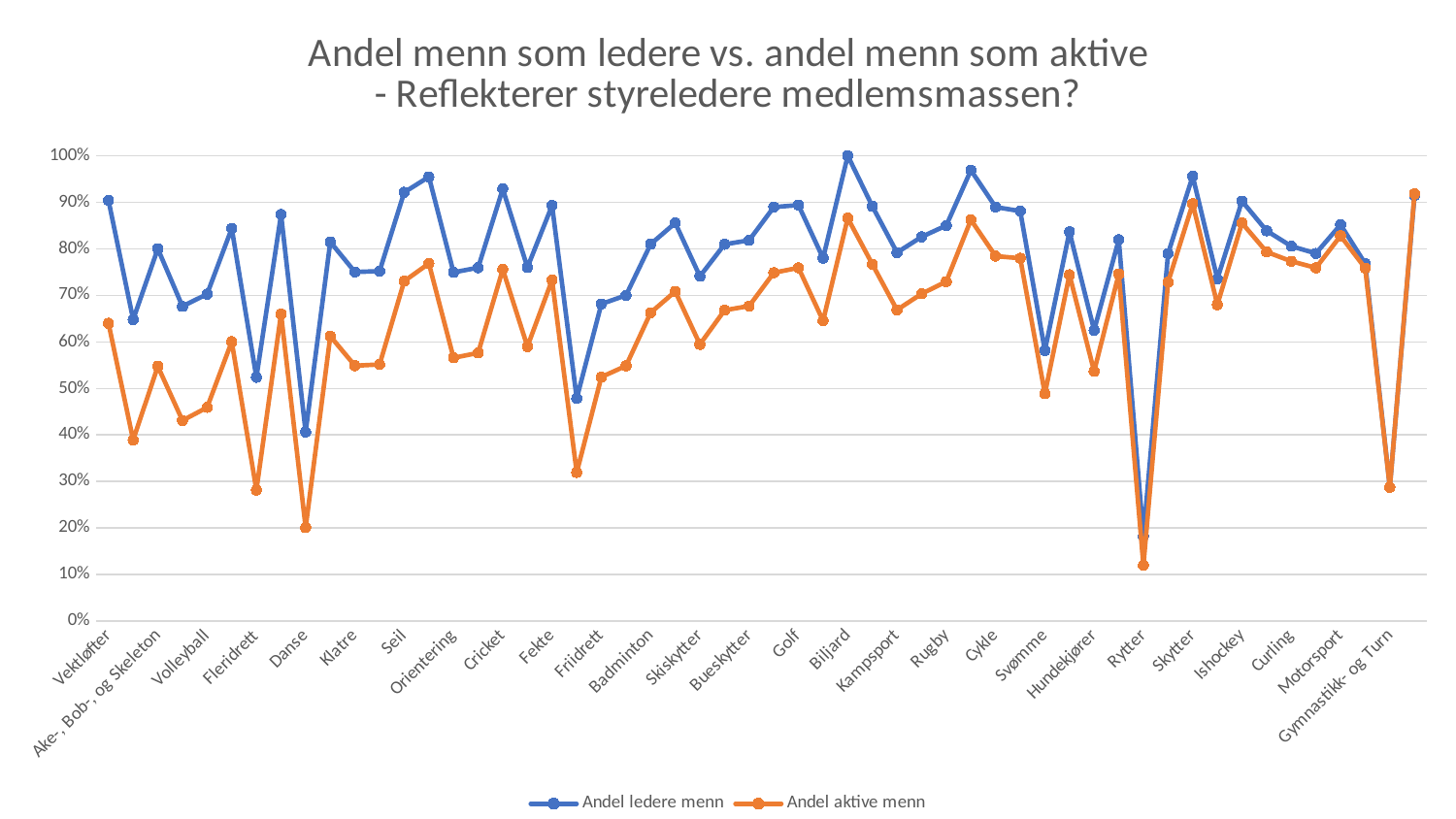
Is the value for Andel ledere menn at Friidrett greater or less than 70%? less Is the value for Andel aktive menn at Rytter greater or less than 20%? less How many series does the legend list? 2 Which category has the highest value for Andel ledere menn? Biljard Which category has the lowest value for Andel aktive menn? Rytter Which category has the lowest value for Andel ledere menn? Rytter At Vektløfter, which series has the larger value, Andel ledere menn or Andel aktive menn? Andel ledere menn What is the value for Andel ledere menn at Biljard? 100% What are the two series named in the legend? Andel ledere menn and Andel aktive menn What kind of chart is shown on the slide? Line chart Is the value for Andel aktive menn at Danse greater or less than 60%? less